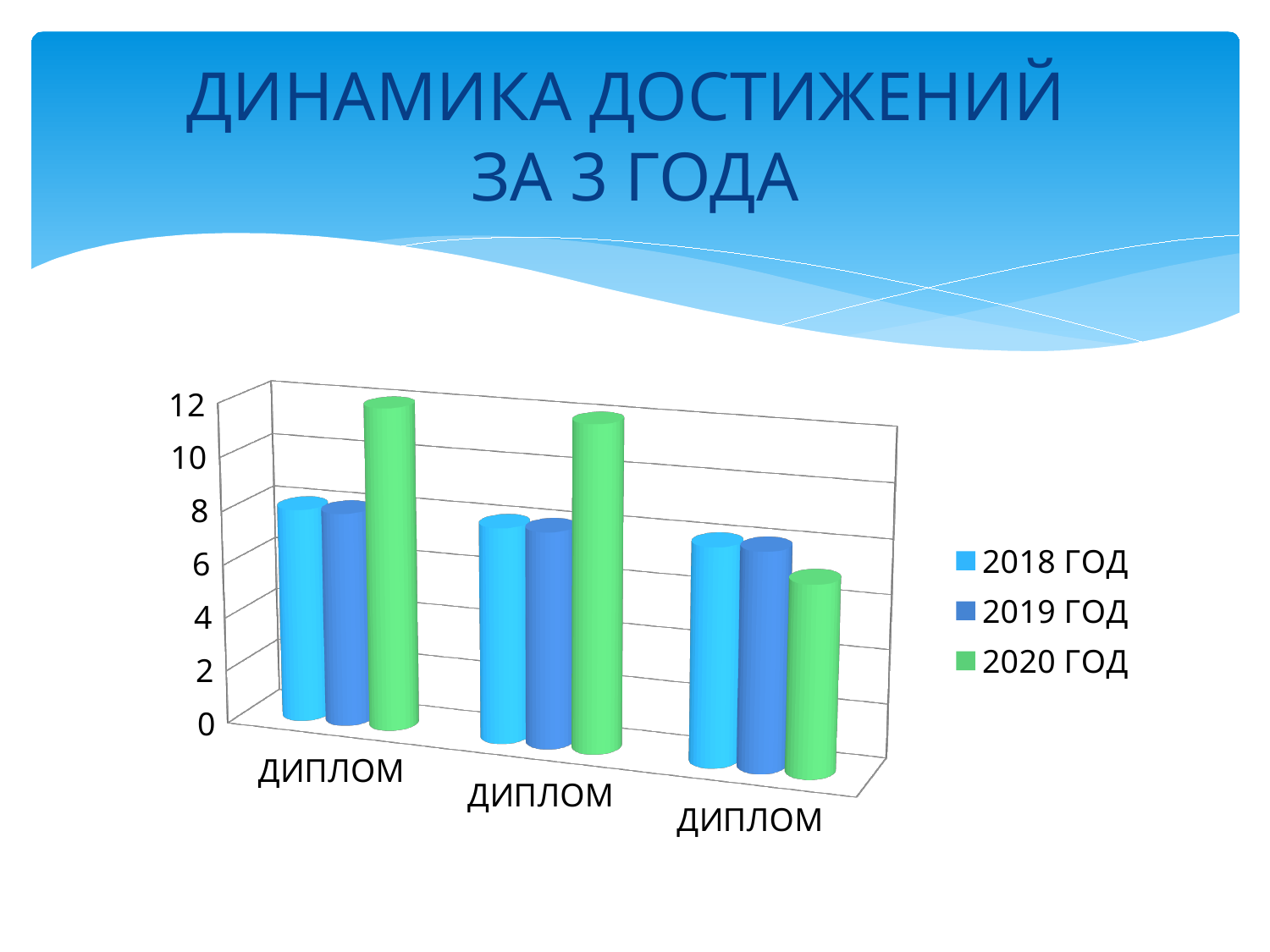
In the first ДИПЛОМ category, which is larger: the value for 2018 ГОД or for 2020 ГОД? 2020 ГОД What kind of chart is shown on the slide? Bar chart How many series does the legend list? 3 For the 2020 ГОД series, which category has the lowest value? The third ДИПЛОМ category How many categories are shown on the x axis? 3 What is the title of the slide containing the chart? ДИНАМИКА ДОСТИЖЕНИЙ ЗА 3 ГОДА In the third ДИПЛОМ category, which is larger: the value for 2018 ГОД or for 2020 ГОД? 2018 ГОД In the third ДИПЛОМ category, is the value for 2018 ГОД greater or less than 10? less In the third ДИПЛОМ category, is the value for 2020 ГОД greater or less than 8? less Do the values for the 2020 ГОД series rise or fall from the first category to the third? Fall In the first ДИПЛОМ category, is the value for 2020 ГОД greater or less than 10? greater What are the series names listed in the legend? 2018 ГОД, 2019 ГОД, 2020 ГОД